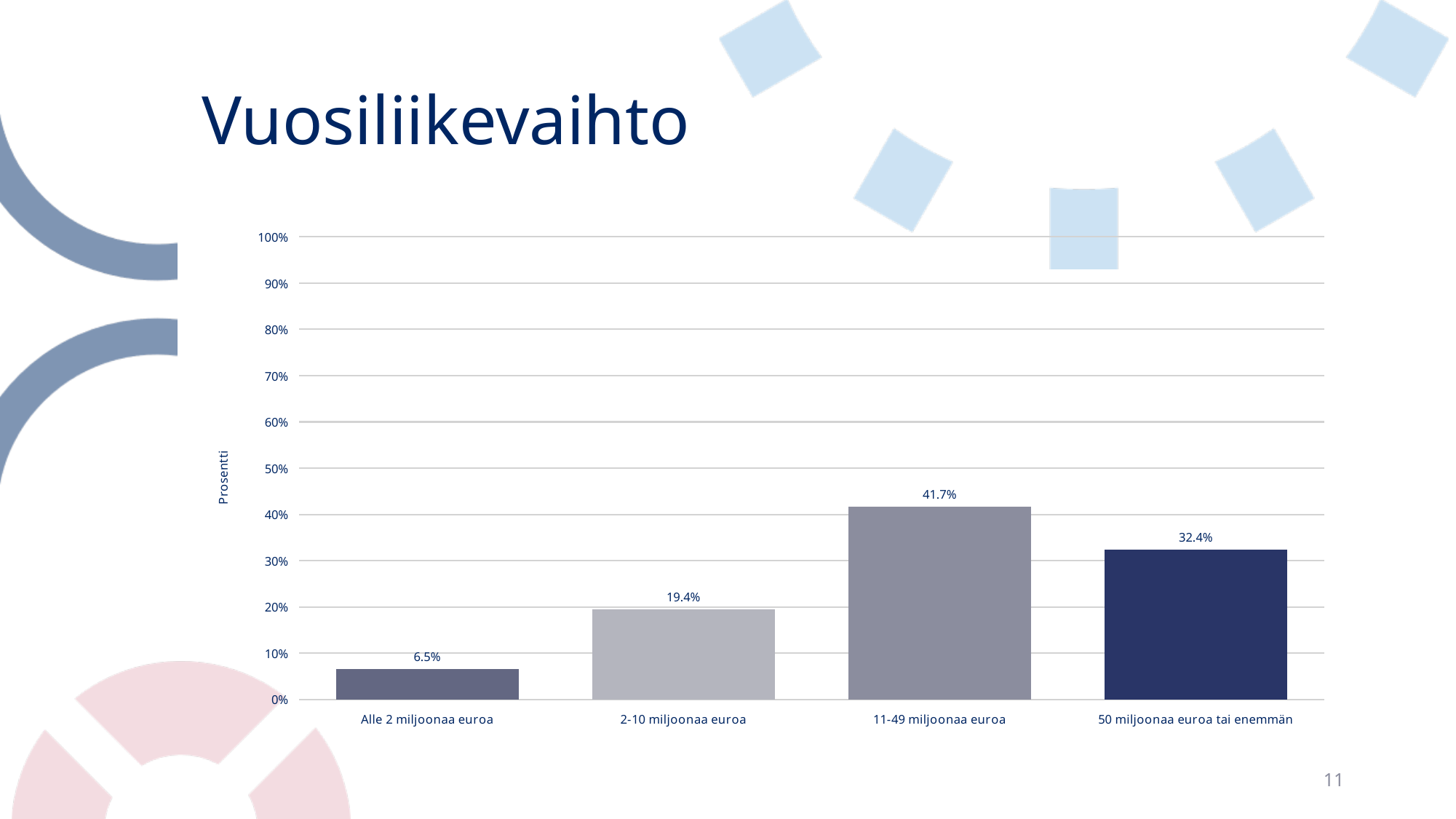
What is the value for "2-10 miljoonaa euroa"? 19.4% Which category has the lowest value? Alle 2 miljoonaa euroa What kind of chart is shown on the slide? bar chart What is the difference between the values for "11-49 miljoonaa euroa" and "50 miljoonaa euroa tai enemmän"? 9.3% What is the value for "50 miljoonaa euroa tai enemmän"? 32.4% Is the value for "11-49 miljoonaa euroa" greater or less than 40%? greater What is the title of the slide containing the chart? Vuosiliikevaihto What is the value for "11-49 miljoonaa euroa"? 41.7% How many categories are shown on the x axis? 4 Which is larger, the value for "2-10 miljoonaa euroa" or the value for "50 miljoonaa euroa tai enemmän"? 50 miljoonaa euroa tai enemmän Which category has the highest value? 11-49 miljoonaa euroa What is the value for "Alle 2 miljoonaa euroa"? 6.5%